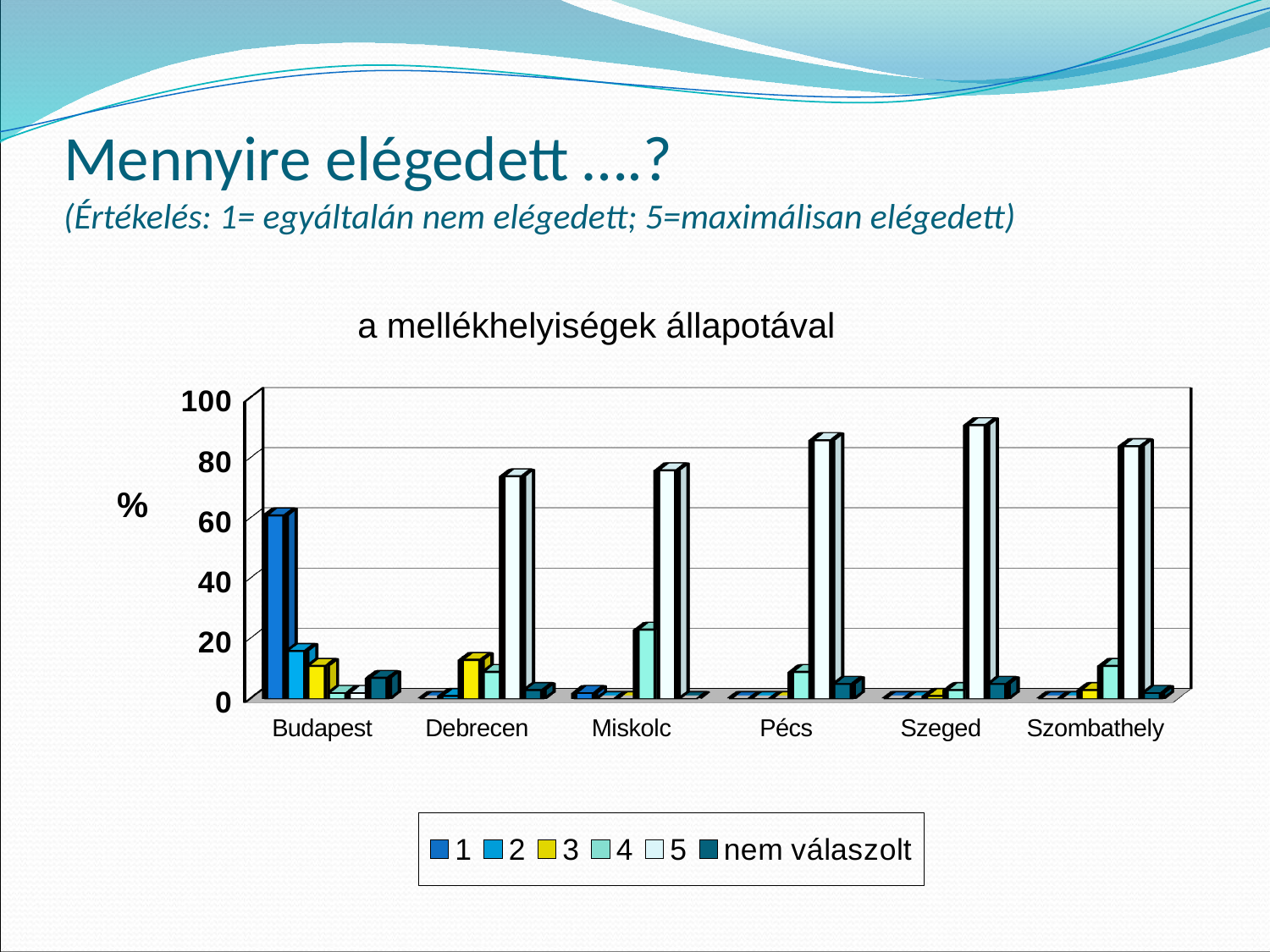
Is the value for series 5 in Debrecen greater or less than 80? less What is the title of the chart? a mellékhelyiségek állapotával Is the value for series 4 in Miskolc greater or less than 40? less How many series does the chart's legend list? 6 Which city has the highest value for series 5? Szeged What label is shown on the vertical axis of the chart? % Which city has the highest value for series 1? Budapest How many cities are shown on the x axis of the chart? 6 Is the value for series 1 in Budapest greater or less than 40? greater What kind of chart is shown on the slide? bar chart In Budapest, which is larger: the value for series 1 or the value for series 2? series 1